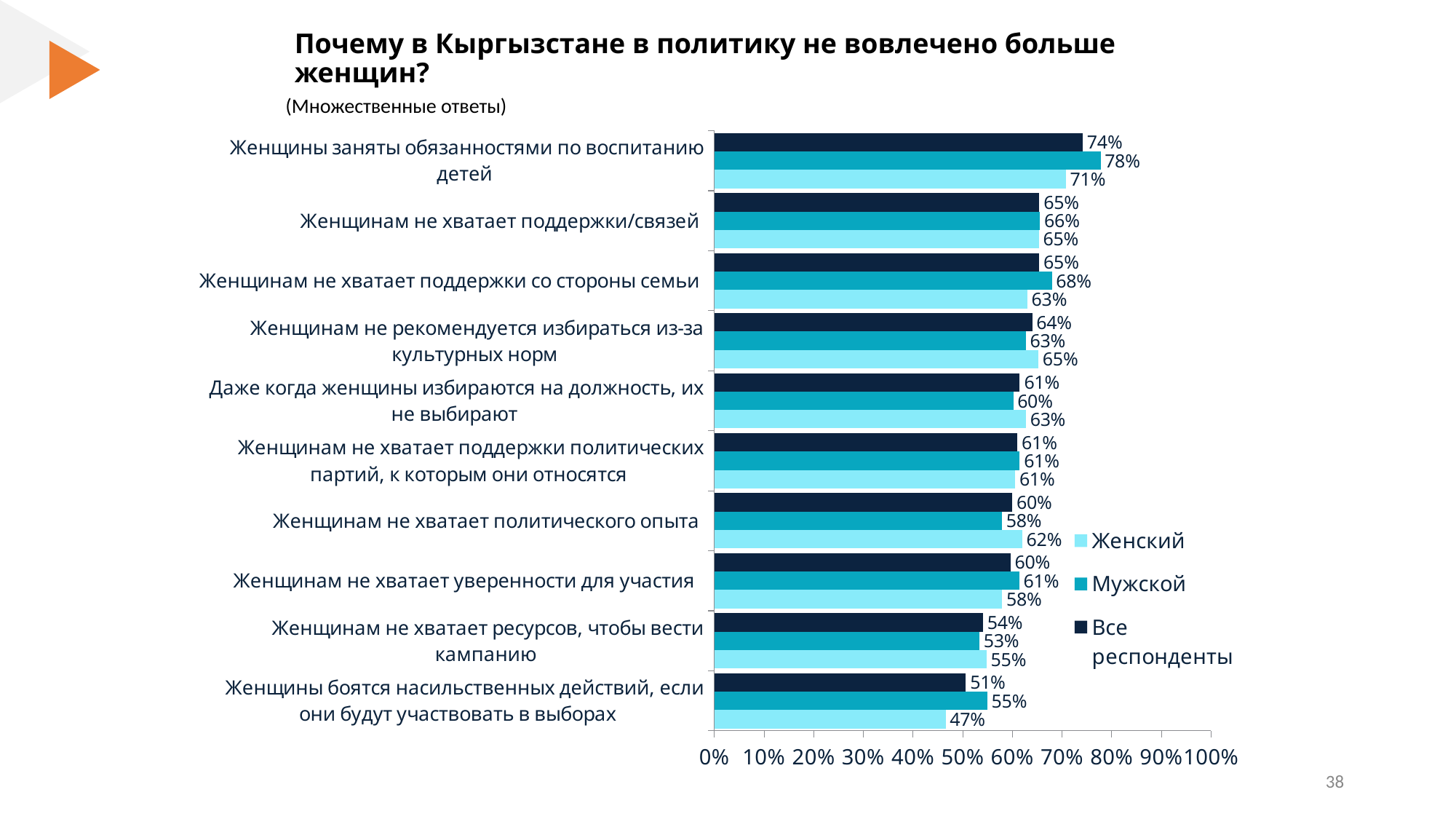
Which series is shown in the darkest (navy) colour in the legend? Все респонденты What is the value for Мужской for 'Женщины заняты обязанностями по воспитанию детей'? 78% For 'Женщинам не хватает поддержки со стороны семьи', which is larger: the Мужской value or the Женский value? Мужской What type of chart is shown on the slide? bar chart What is the difference between the Мужской and Женский values for 'Женщины боятся насильственных действий, если они будут участвовать в выборах'? 8% Which category has the highest value for Все респонденты? Женщины заняты обязанностями по воспитанию детей What is the difference between the Мужской and Женский values for 'Женщины заняты обязанностями по воспитанию детей'? 7% What is the value for Все респонденты for 'Женщинам не хватает ресурсов, чтобы вести кампанию'? 54% What is the value for Женский for 'Женщины боятся насильственных действий, если они будут участвовать в выборах'? 47% Which category has the lowest value for Женский? Женщины боятся насильственных действий, если они будут участвовать в выборах How many series does the legend list? 3 How many categories (reasons) are shown in the chart? 10